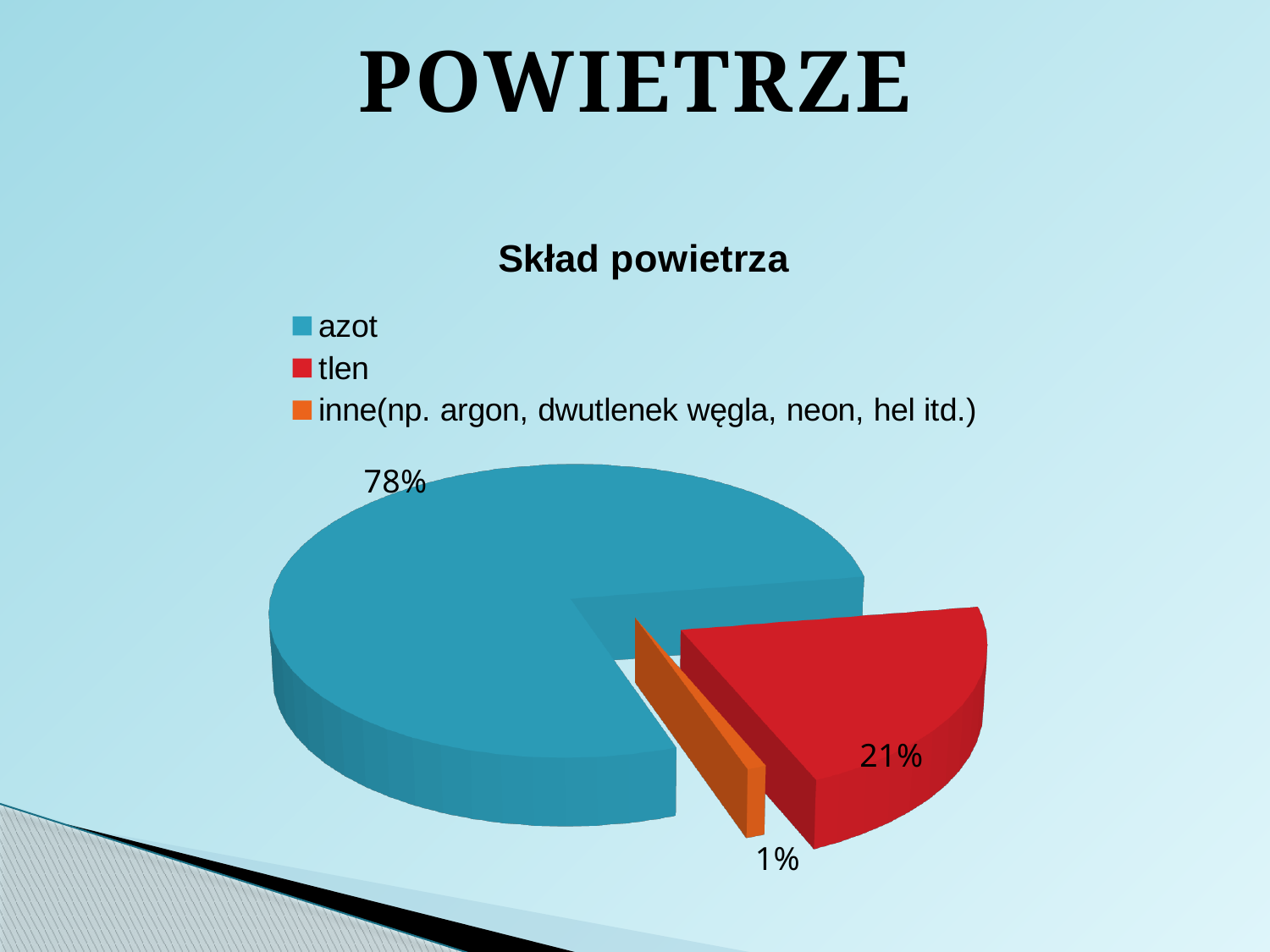
What percentage of the pie is labelled for tlen? 21% How many categories does the legend list? 3 What is the title of the chart? Skład powietrza What percentage of the pie is labelled for azot? 78% What colour is the slice for tlen? red What is the combined share of tlen and inne(np. argon, dwutlenek węgla, neon, hel itd.)? 22% What is the difference in percentage points between azot and tlen? 57 Which category has the smallest slice of the pie? inne(np. argon, dwutlenek węgla, neon, hel itd.) What type of chart is shown on the slide? pie chart What percentage of the pie is labelled for inne(np. argon, dwutlenek węgla, neon, hel itd.)? 1% Which is larger, the slice for tlen or the slice for inne(np. argon, dwutlenek węgla, neon, hel itd.)? tlen Which category has the largest slice of the pie? azot